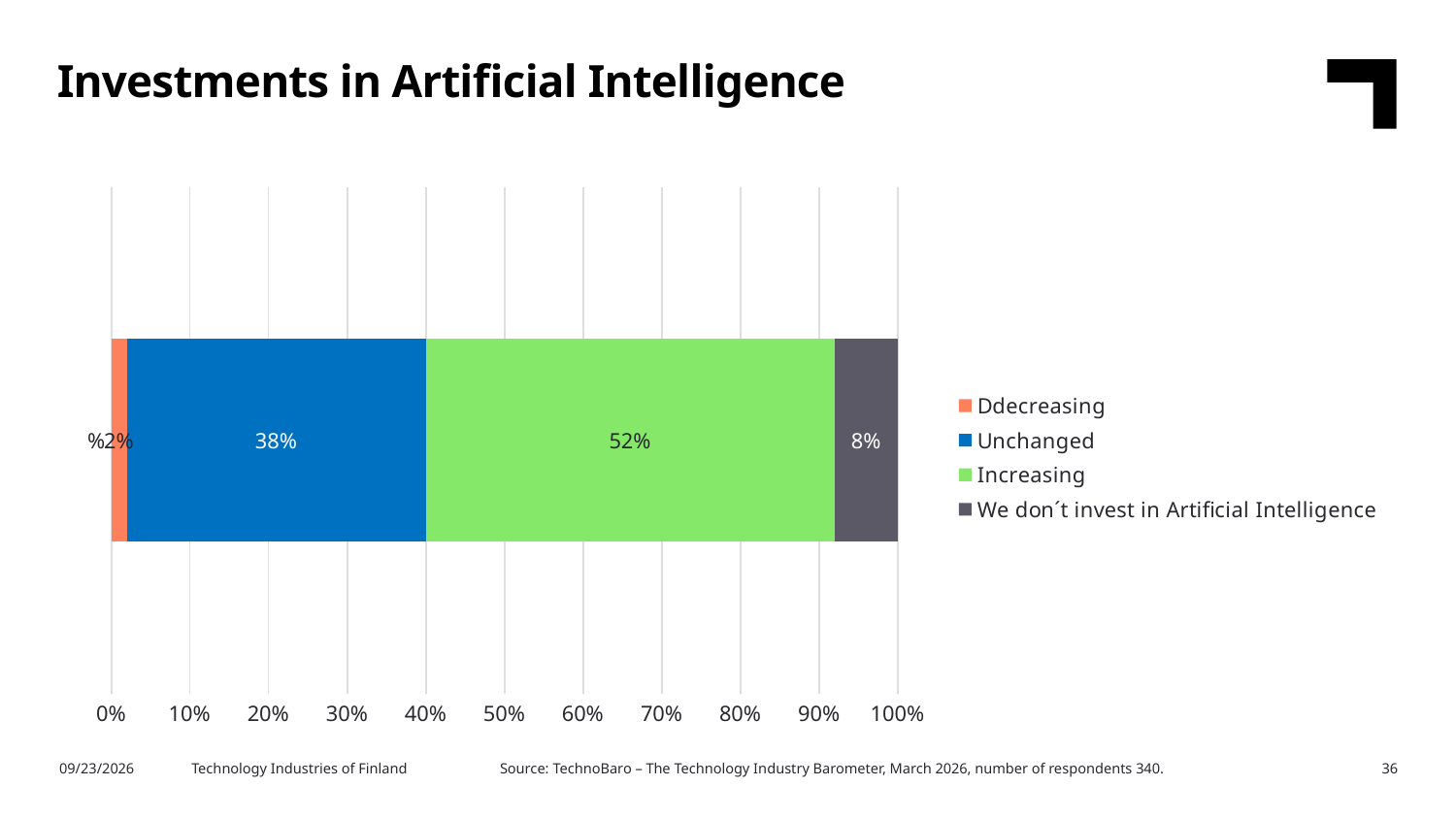
Which is larger: the share for Unchanged or the share for We don't invest in Artificial Intelligence? Unchanged What kind of chart is shown on the slide? Stacked bar chart What is the difference between the share of respondents reporting increasing investments and those reporting unchanged investments? 14% What percentage of respondents report that their investments in Artificial Intelligence are unchanged? 38% What percentage of respondents say they don't invest in Artificial Intelligence? 8% What is the title of the chart on the slide? Investments in Artificial Intelligence Which response category has the smallest share in the chart? Ddecreasing Is the share for Increasing greater or less than 50%? greater What is the difference between the share of respondents reporting unchanged investments and those who don't invest in Artificial Intelligence? 30% What percentage of respondents report that their investments in Artificial Intelligence are increasing? 52% How many series does the legend list? 4 Which response category has the largest share in the chart? Increasing